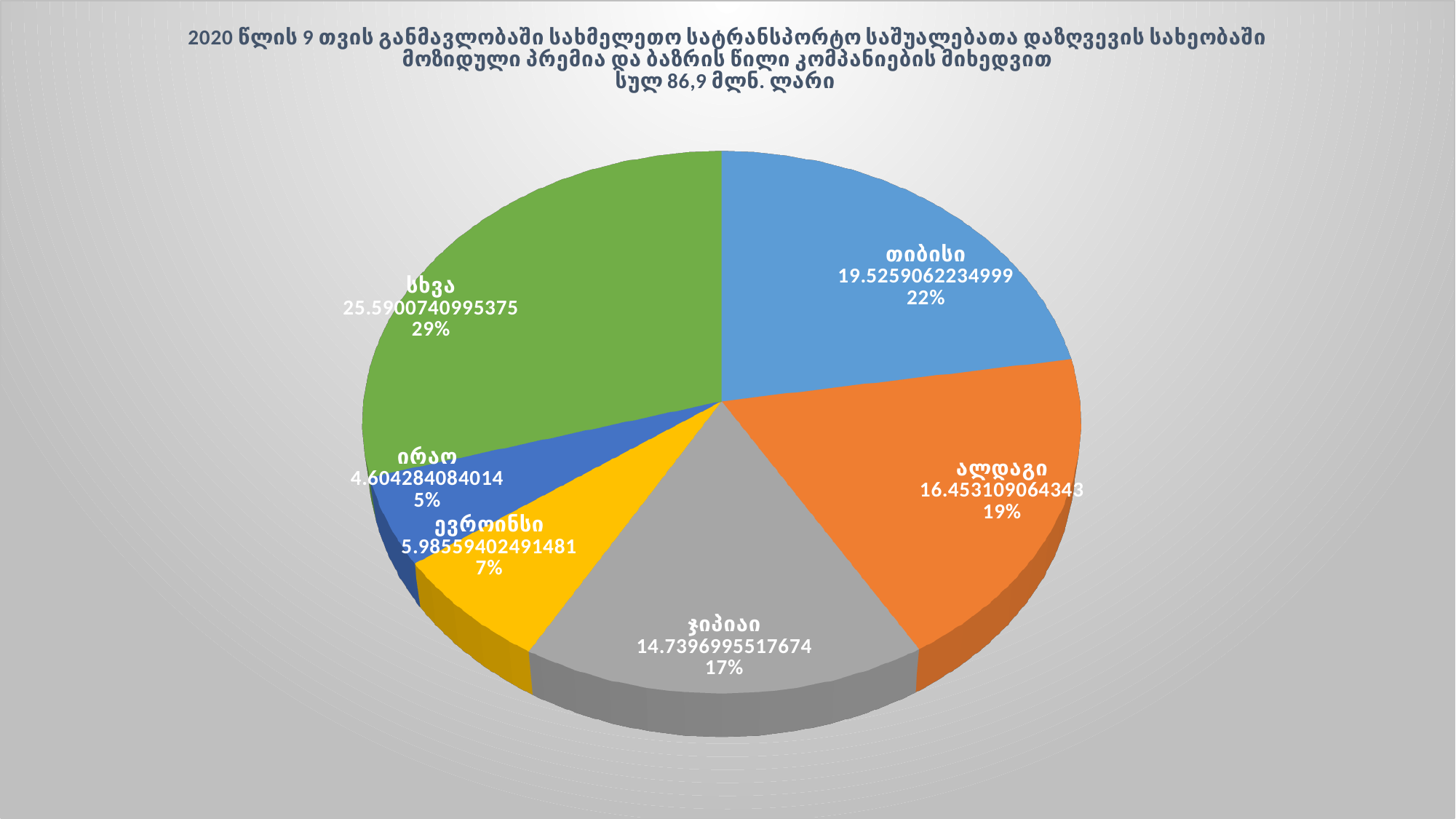
What share of the pie does ჯიპიაი hold? 17% Which is larger, the share for ალდაგი or the share for ჯიპიაი? ალდაგი What share of the pie does სხვა hold? 29% Which slice is the largest? სხვა What is the value shown for ევროინსი? 5.98559402491481 Which slice is the smallest? ირაო What is the value shown for ალდაგი? 16.453109064343 How many slices does the pie chart have? 6 What kind of chart is shown on the slide? pie chart What is the difference in percentage points between the share of თიბისი and the share of ალდაგი? 3 What is the value shown for ირაო? 4.604284084014 What is the value shown for თიბისი? 19.5259062234999